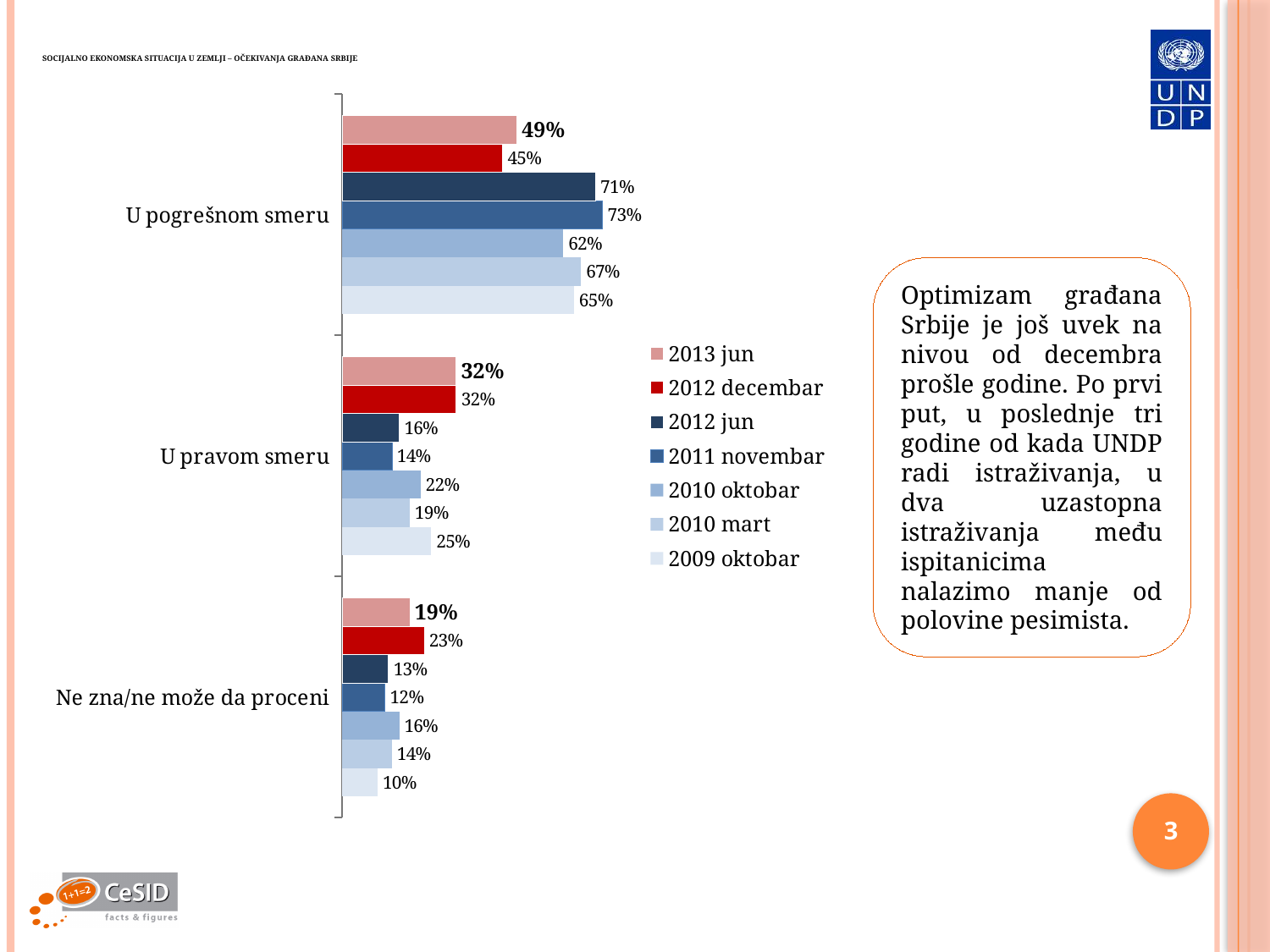
In the "U pravom smeru" category, which is larger: the value for 2010 oktobar or the value for 2010 mart? 2010 oktobar Which legend entry is listed first in the chart's legend? 2013 jun What is the value for 2009 oktobar in the "Ne zna/ne može da proceni" category? 10% How many series does the legend list? 7 Which survey wave has the highest value in the "U pogrešnom smeru" category? 2011 novembar What is the value for 2013 jun in the "U pogrešnom smeru" category? 49% How many categories are shown on the chart? 3 Which survey wave has the lowest value in the "Ne zna/ne može da proceni" category? 2009 oktobar What is the difference between the 2012 decembar and 2012 jun values in the "Ne zna/ne može da proceni" category? 10% What is the difference between the 2011 novembar and 2013 jun values in the "U pogrešnom smeru" category? 24% What kind of chart is shown on the slide? Bar chart What is the value for 2011 novembar in the "U pravom smeru" category? 14%